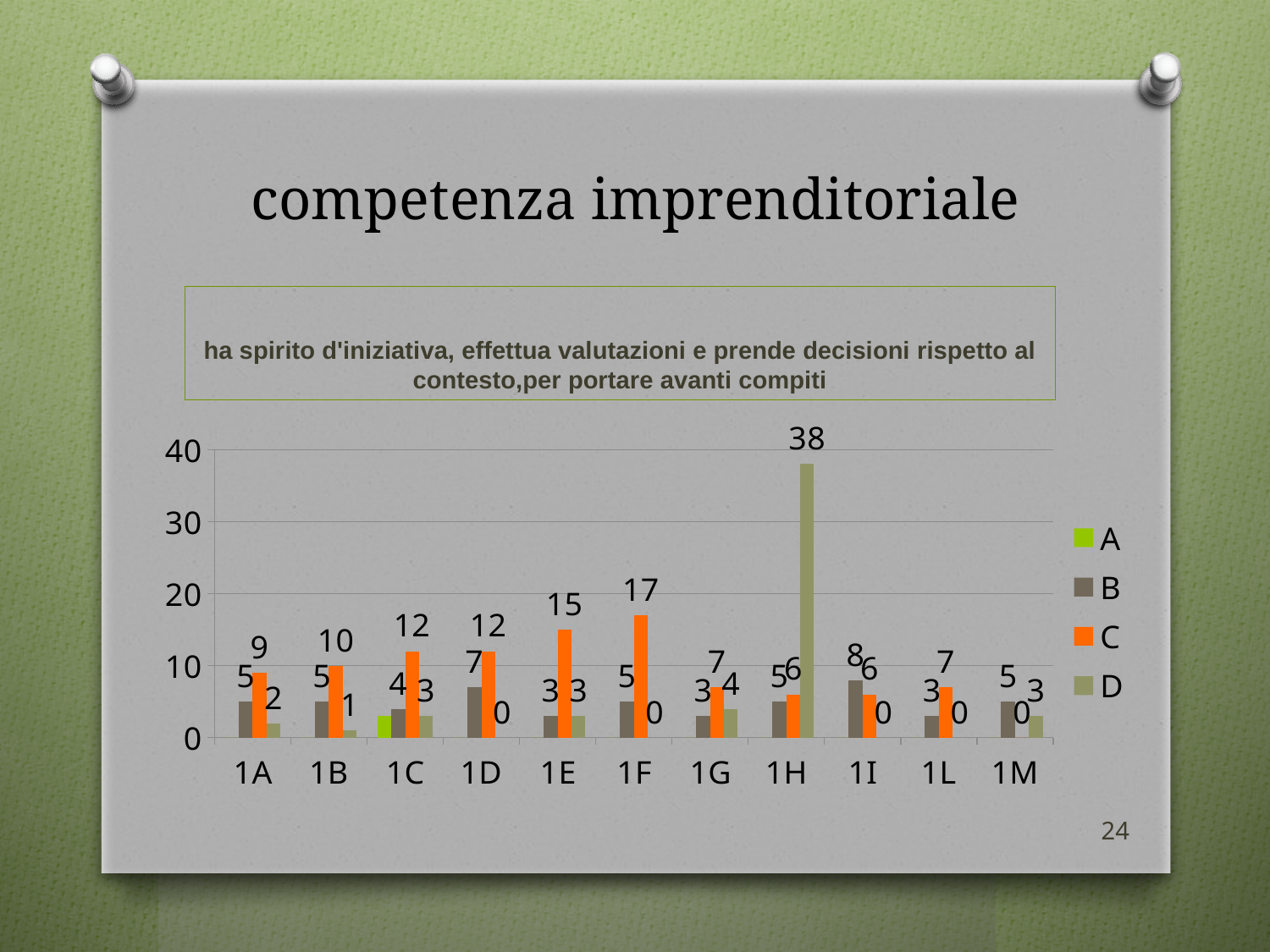
How many series does the chart legend list? 4 Which category has the highest value for series C? 1F What kind of chart is shown on the slide? bar chart Which is larger: the series B value for 1I or the series B value for 1D? 1I What is the title of the slide containing the chart? competenza imprenditoriale What is the difference between the series C values for 1F and 1E? 2 How many categories are shown on the x axis of the chart? 11 What is the value of series C for category 1M? 0 What is the value of series B for category 1I? 8 What is the value of series D for category 1H? 38 Is the value of series D for category 1H greater or less than 30? greater What is the value of series C for category 1F? 17